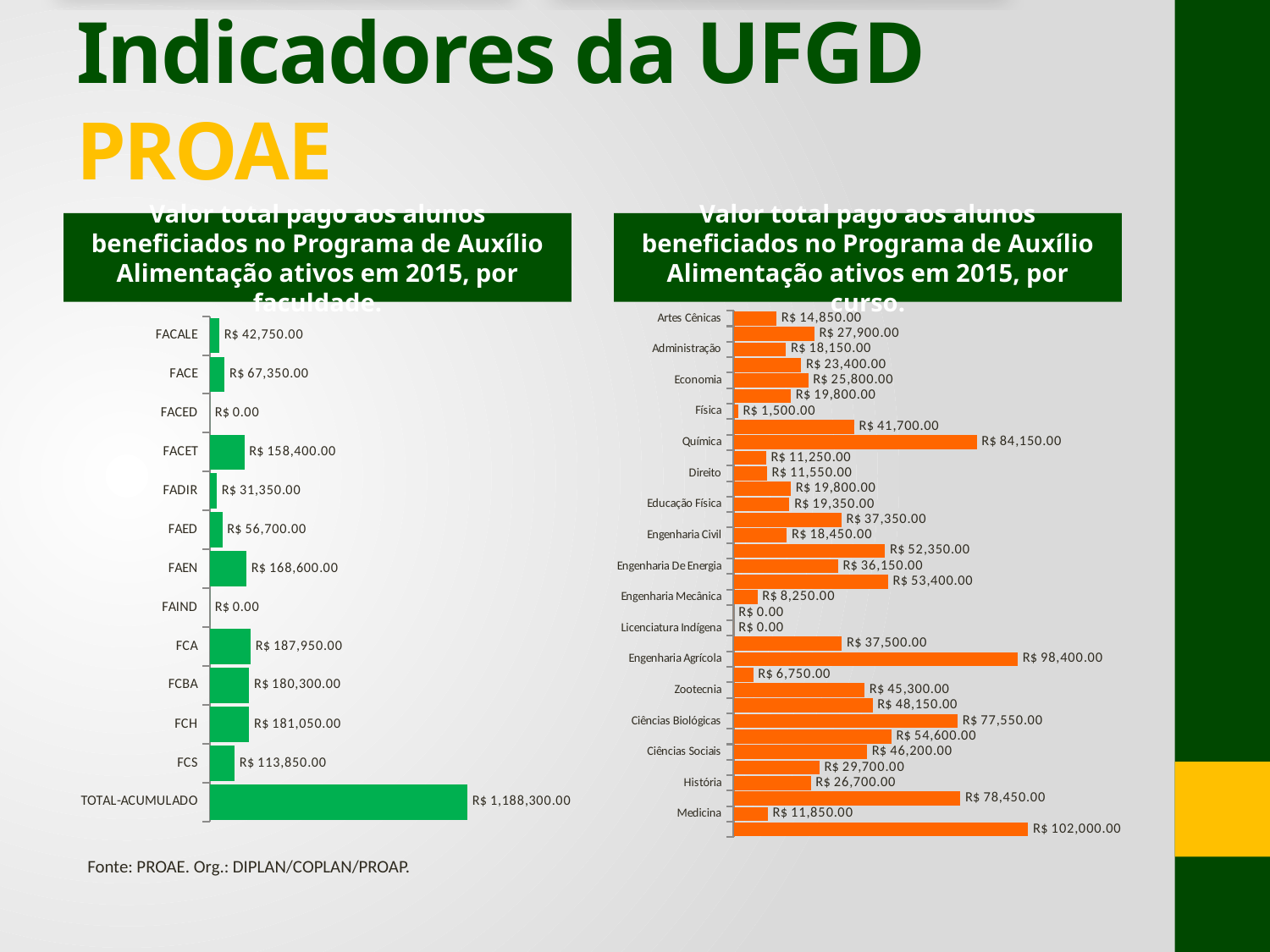
In the left chart (por faculdade), how many categories are plotted, including TOTAL-ACUMULADO? 13 In the left chart (por faculdade), which is larger, the value for FACE or the value for FAED? FACE What kind of chart is the right chart (por curso)? Bar chart In the left chart (por faculdade), how many faculties show a value of R$ 0.00? 2 In the left chart (por faculdade), what is the value for FCS? R$ 113,850.00 In the right chart (por curso), what is the largest value labelled on any bar? R$ 102,000.00 In the left chart (por faculdade), what is the value for FACET? R$ 158,400.00 What colour are the bars in the left chart (por faculdade)? Green In the left chart (por faculdade), which faculty (excluding TOTAL-ACUMULADO) has the highest value? FCA In the left chart (por faculdade), what is the difference between the values for FCA and FCBA? R$ 7,650.00 In the left chart (por faculdade), what is the value for TOTAL-ACUMULADO? R$ 1,188,300.00 In the left chart (por faculdade), what is the difference between the values for FAEN and FACET? R$ 10,200.00